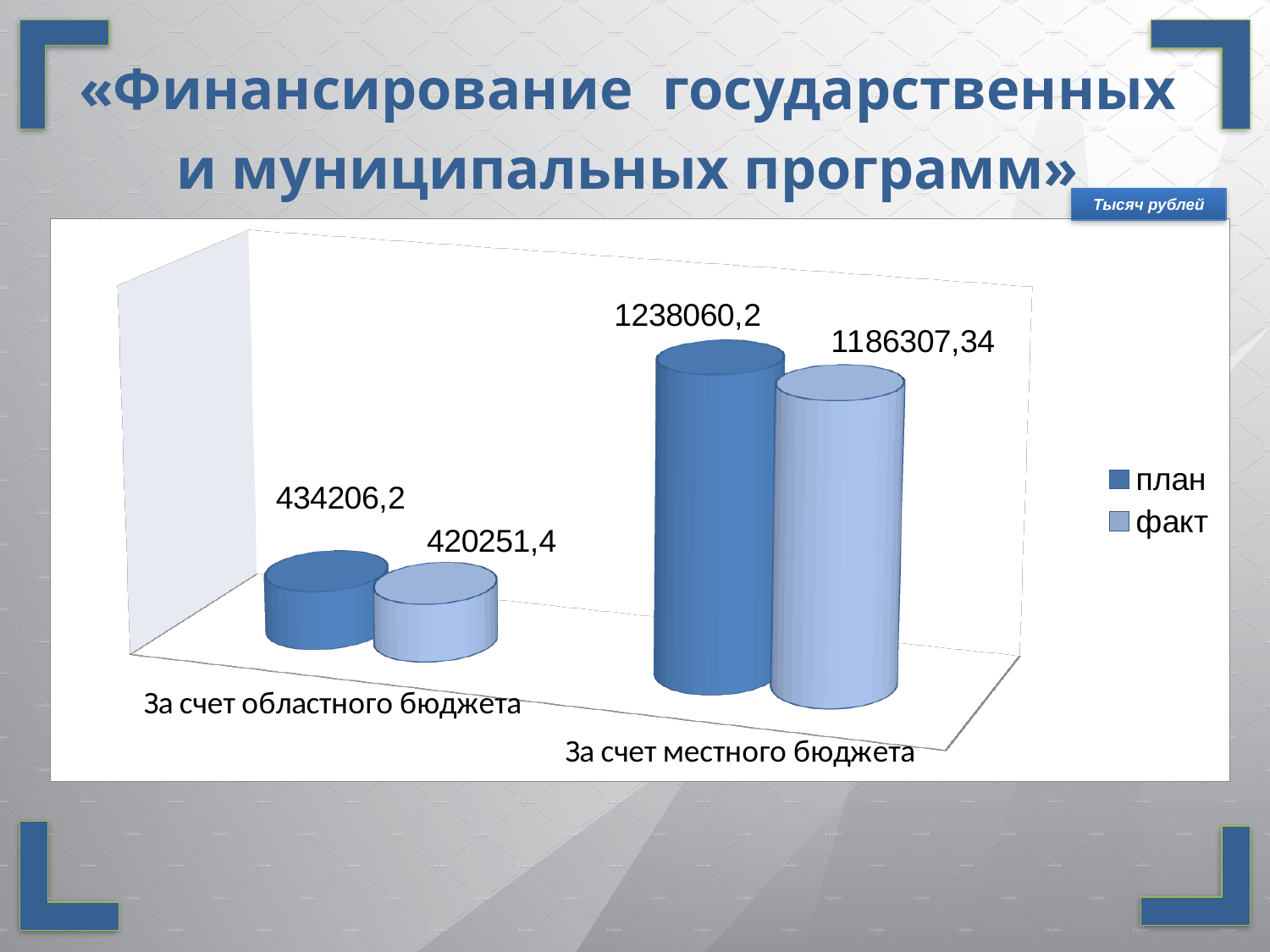
What unit of measurement is indicated for the chart values? Тысяч рублей What is the факт value for «За счет местного бюджета»? 1186307,34 Which category has the highest план value? За счет местного бюджета For «За счет местного бюджета», which is larger: план or факт? план What is the план value for «За счет местного бюджета»? 1238060,2 What is the факт value for «За счет областного бюджета»? 420251,4 What is the difference between план and факт for «За счет областного бюджета»? 13954,8 Which category has the lowest факт value? За счет областного бюджета What is the difference between план and факт for «За счет местного бюджета»? 51752,86 How many series does the legend list? 2 What is the план value for «За счет областного бюджета»? 434206,2 How many categories are shown on the chart? 2